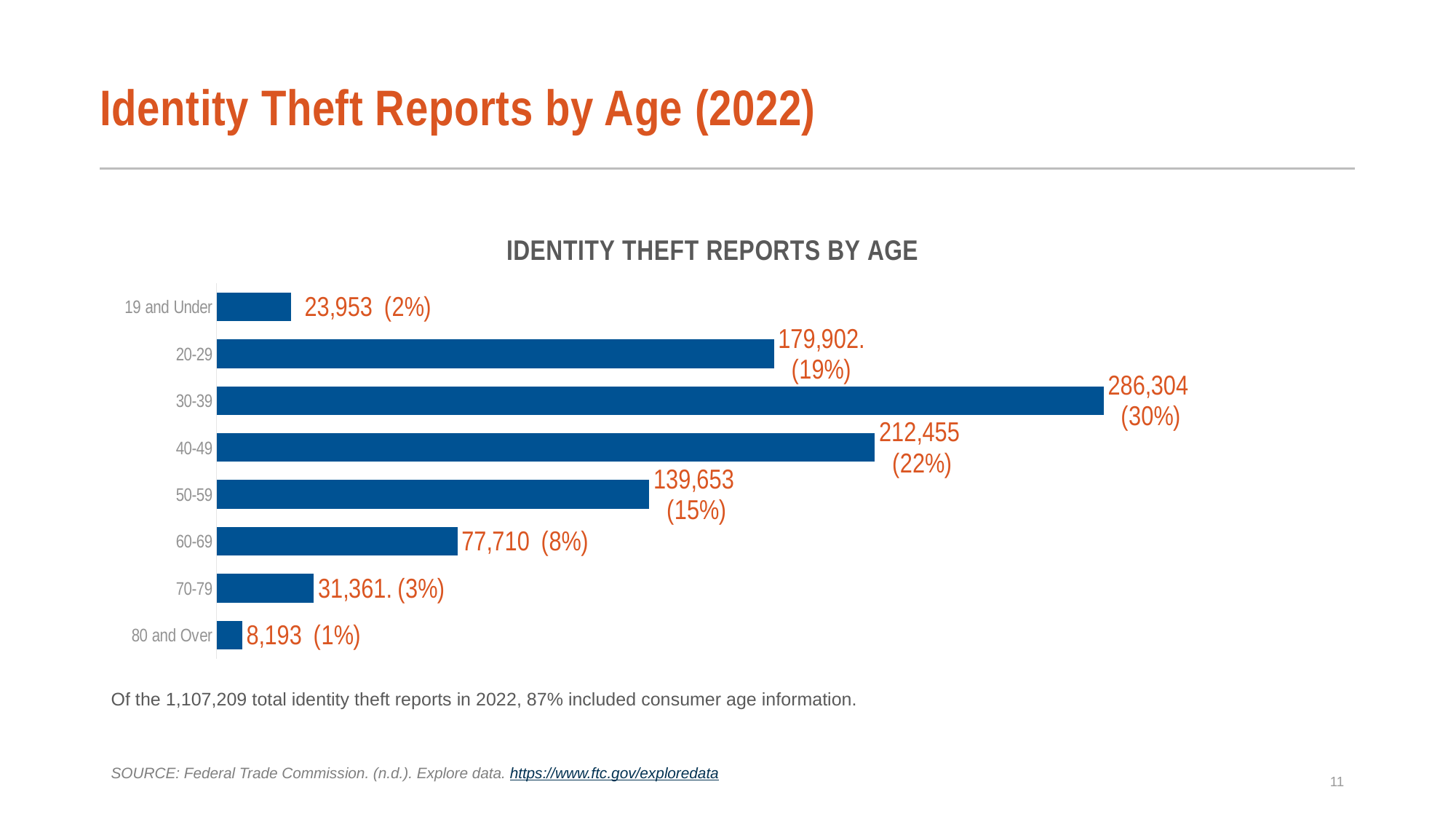
What type of chart is used to show identity theft reports by age? Bar chart How many age groups are shown in the chart? 8 Which age group has the lowest number of identity theft reports? 80 and Over What is the number of identity theft reports for the 30-39 age group? 286,304 What is the number of identity theft reports for the 80 and Over age group? 8,193 Which age group has the highest number of identity theft reports? 30-39 What percentage of identity theft reports is shown for the 40-49 age group? 22% What is the difference in identity theft reports between the 30-39 and 40-49 age groups? 73,849 What is the difference in identity theft reports between the 60-69 and 70-79 age groups? 46,349 Which age group has more identity theft reports, 20-29 or 50-59? 20-29 What is the number of identity theft reports for the 50-59 age group? 139,653 What is the title of the chart? IDENTITY THEFT REPORTS BY AGE